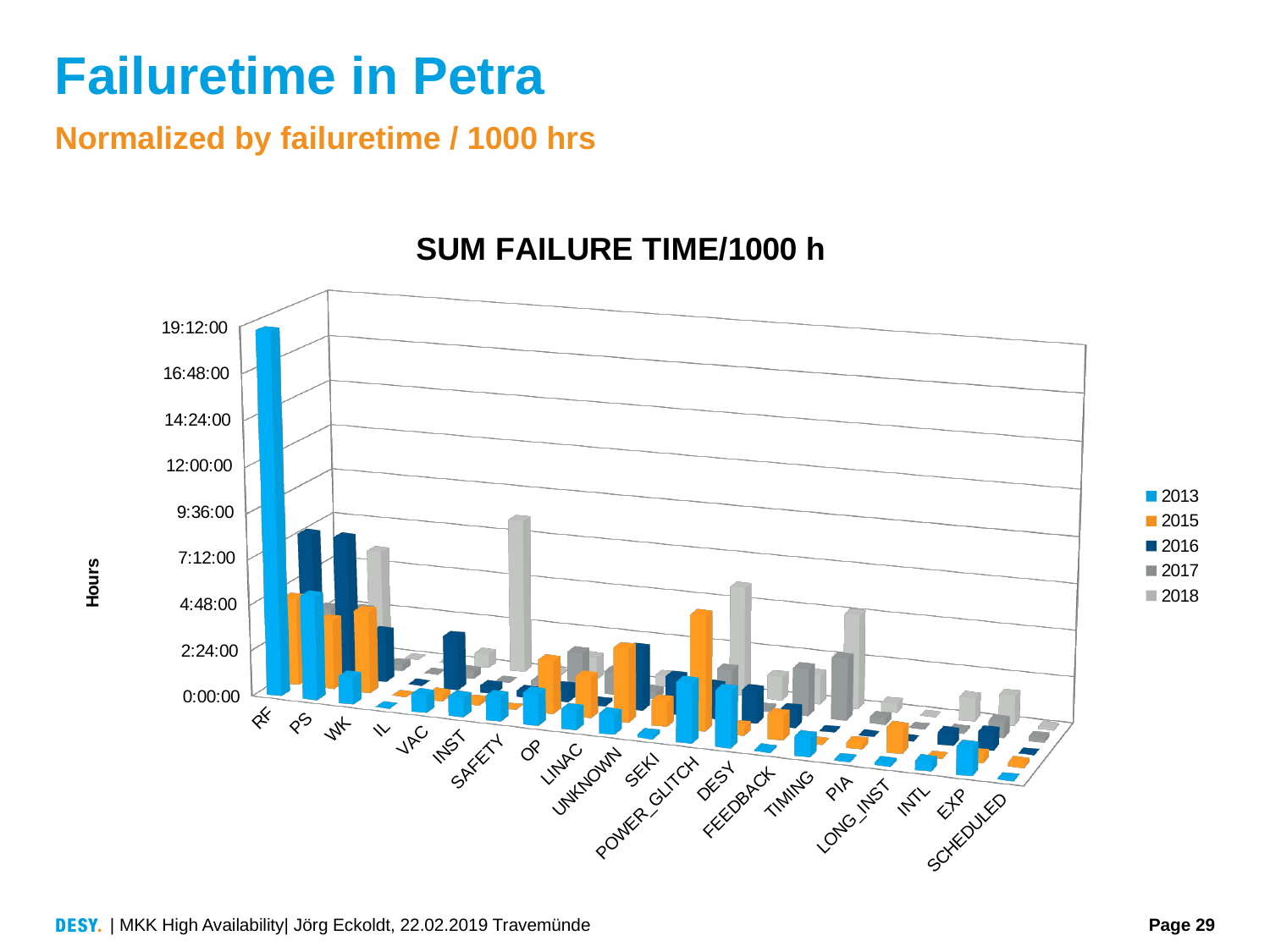
Is the 2013 value for RF greater or less than 12:00:00? greater How many categories are shown on the x axis of the chart? 20 Which category has the tallest bar in the whole chart? RF Which category is listed last on the x axis? SCHEDULED What is the title of the chart? SUM FAILURE TIME/1000 h Which is larger, the 2013 value for RF or the 2013 value for PS? RF Which category is listed first on the x axis? RF How many series does the legend list? 5 What type of chart is shown on the slide? bar chart What is the label of the vertical axis? Hours Which category has the highest value for the 2013 series? RF